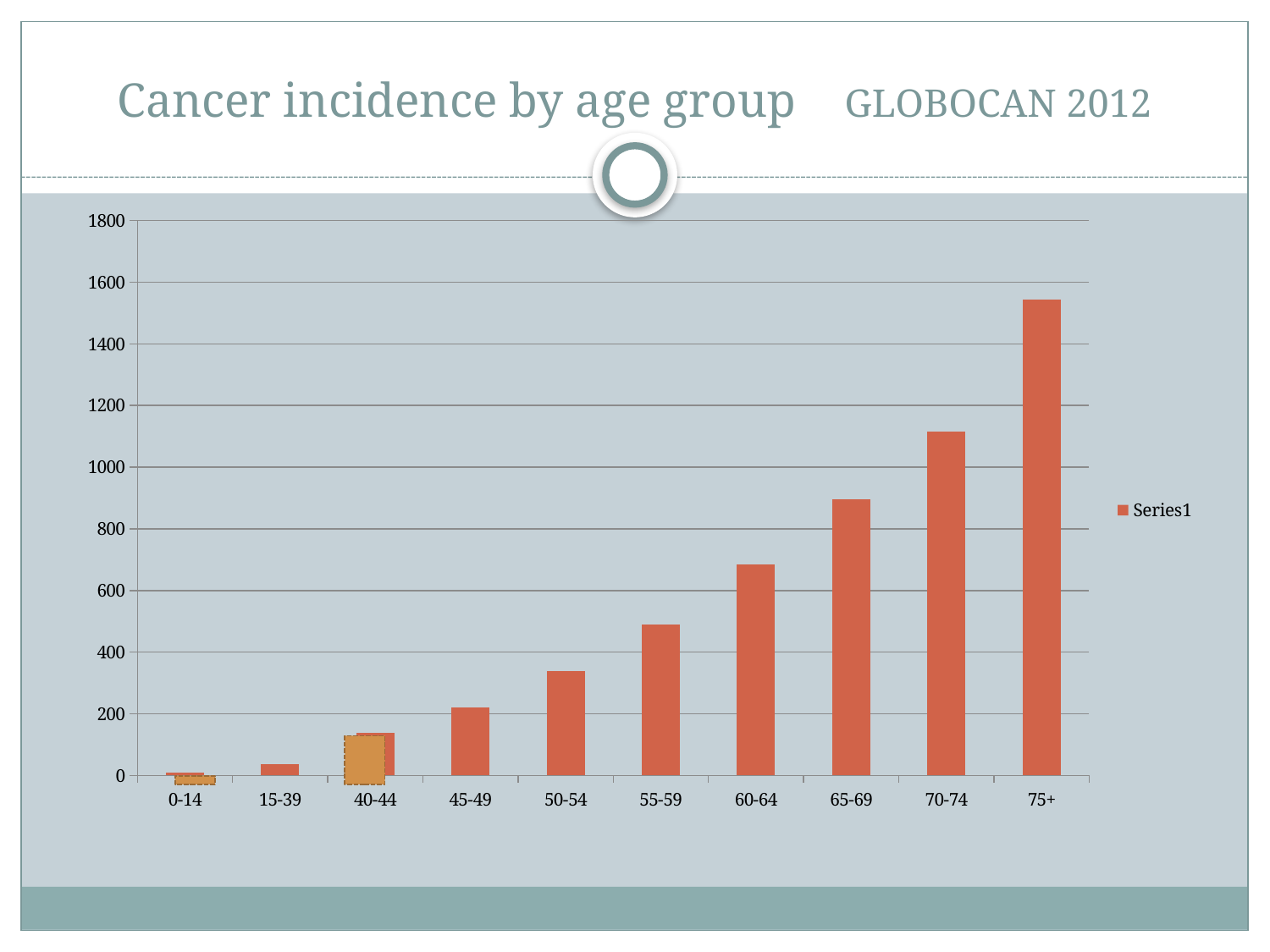
Which age group has the larger value, 60-64 or 50-54? 60-64 What is the name of the series shown in the chart legend? Series1 How many age groups are shown on the x axis of the chart? 10 Is the value for the 75+ age group greater or less than 1400? greater What kind of chart is shown on the slide? bar chart Which age group has the highest cancer incidence in the chart? 75+ Is the value for the 65-69 age group greater or less than 1000? less Which age group has the lowest cancer incidence in the chart? 0-14 How many series does the chart legend list? 1 Is the value for the 70-74 age group greater or less than 1000? greater Do the values generally rise or fall as the age groups move from left to right along the x axis? rise